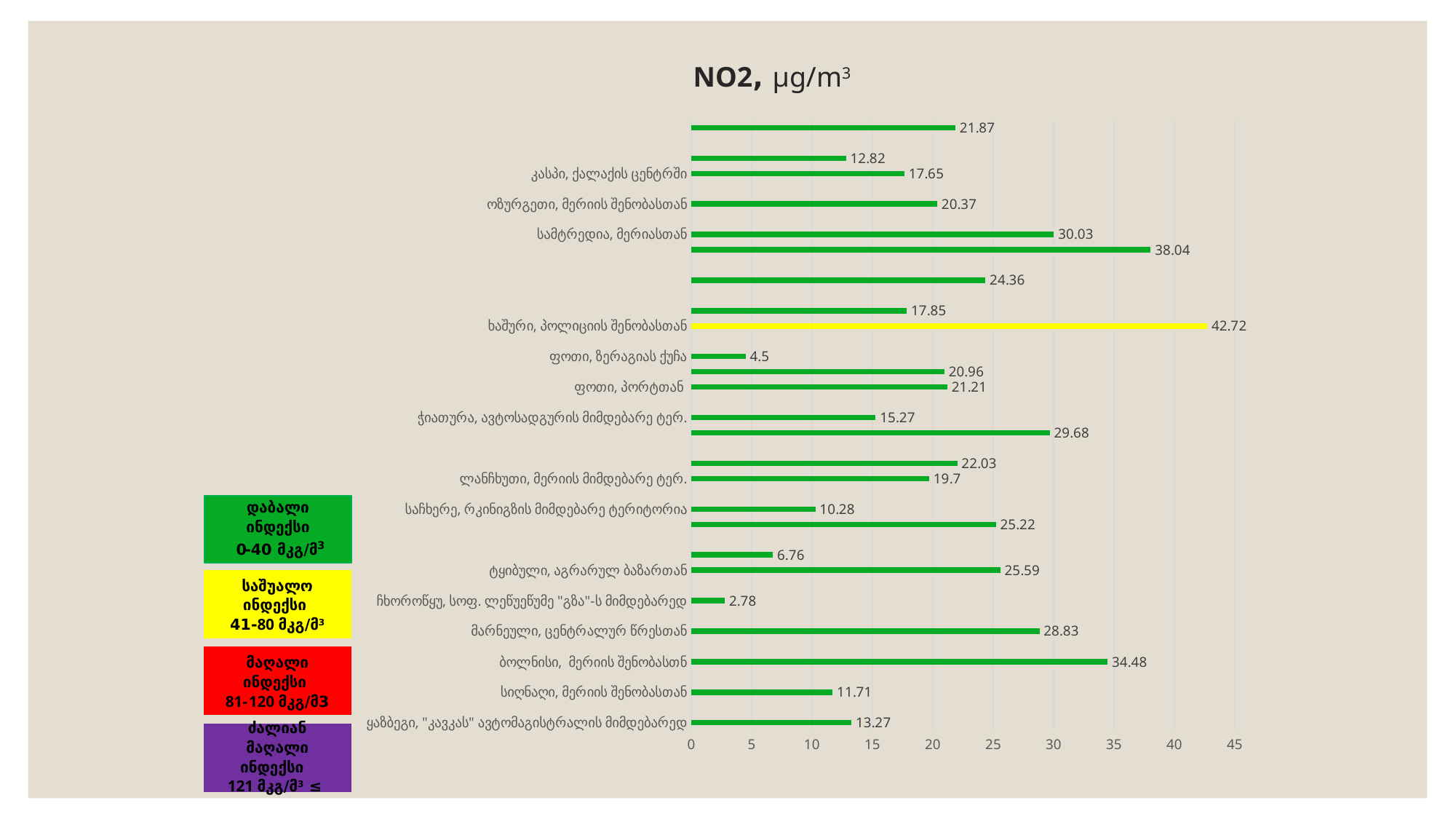
How many bars are plotted in the chart? 25 What is the NO2 value for ფოთი, ზერაგიას ქუჩა? 4.5 What is the NO2 value for ბოლნისი, მერიის შენობასთან? 34.48 What is the difference between the NO2 values for სამტრედია, მერიასთან and ოზურგეთი, მერიის შენობასთან? 9.66 What is the title of the chart? NO2, µg/m³ What is the NO2 value for ხაშური, პოლიციის შენობასთან? 42.72 Which location has the highest NO2 value? ხაშური, პოლიციის შენობასთან Which location has the lowest NO2 value? ჩხოროწყუ, სოფ. ლეწუეწუმე "გზა"-ს მიმდებარედ Is the NO2 value for ყაზბეგი, "კავკას" ავტომაგისტრალის მიმდებარედ greater or less than 15? less Which has a higher NO2 value: ტყიბული, აგრარულ ბაზართან or სიღნაღი, მერიის შენობასთან? ტყიბული, აგრარულ ბაზართან What type of chart is shown on the slide? bar chart What is the NO2 value for მარნეული, ცენტრალურ წრესთან? 28.83